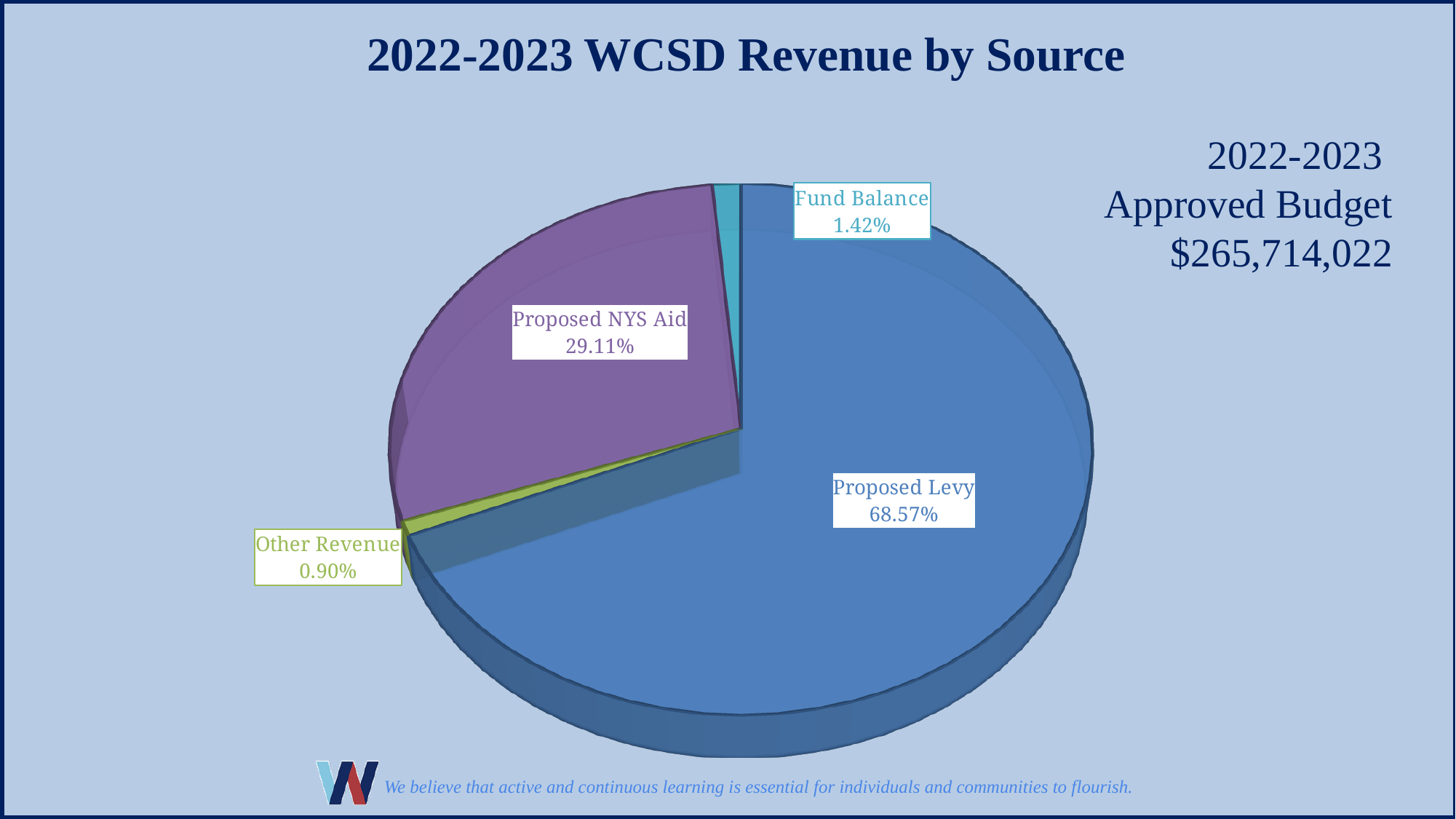
How many revenue sources are shown in the pie chart? 4 What share of revenue does Fund Balance represent? 1.42% What share of revenue does Proposed NYS Aid represent? 29.11% What share of revenue does Proposed Levy represent? 68.57% What is the 2022-2023 Approved Budget amount shown on the slide? $265,714,022 Which revenue source has the largest share? Proposed Levy What share of revenue does Other Revenue represent? 0.90% What is the title of the chart? 2022-2023 WCSD Revenue by Source What kind of chart is shown on the slide? Pie chart What is the difference in percentage points between Proposed Levy and Proposed NYS Aid? 39.46 Which revenue source has the smallest share? Other Revenue Which is larger, Fund Balance or Other Revenue? Fund Balance